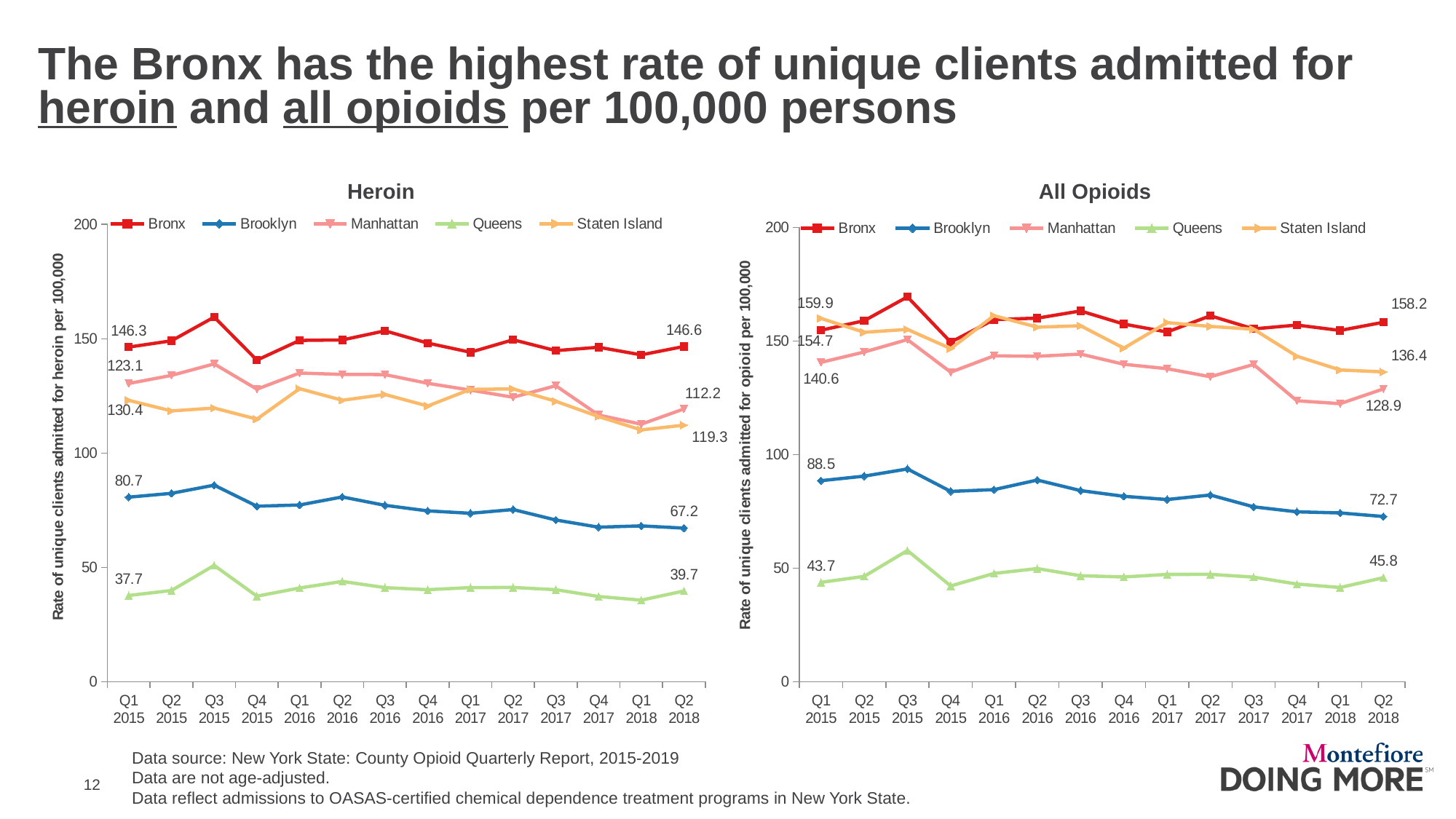
In the All Opioids chart, by how much did Brooklyn's rate fall from Q1 2015 (88.5) to Q2 2018 (72.7)? 15.8 In the All Opioids chart, which borough has the lowest rate in Q2 2018? Queens What type of chart is the Heroin chart? Line chart In the Heroin chart, what is the rate for the Bronx in Q1 2015? 146.3 How many series does the legend of the All Opioids chart list? 5 In the Heroin chart, which borough has the highest rate in Q2 2018? Bronx In the All Opioids chart, which is larger in Q2 2018: Staten Island or Manhattan? Staten Island In the All Opioids chart, what is the rate for the Bronx in Q2 2018? 158.2 In the Heroin chart, what is the rate for Brooklyn in Q2 2018? 67.2 In the All Opioids chart, what is the rate for Queens in Q1 2015? 43.7 How many quarters are plotted along the x axis of the Heroin chart? 14 In the Heroin chart, is the Bronx value for Q3 2015 greater or less than 150? greater